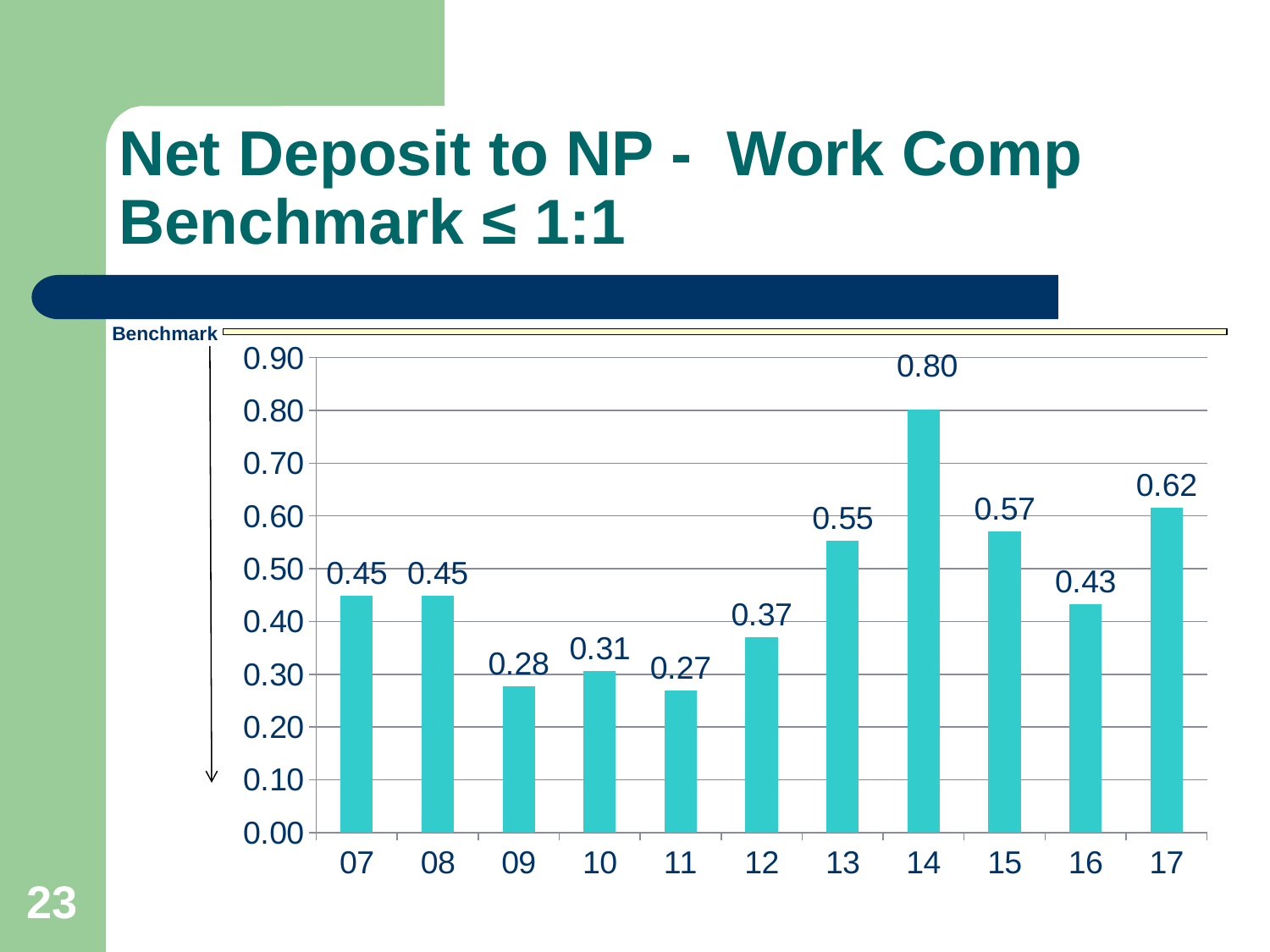
What is the value for 14? 0.80 How many years are shown on the x axis? 11 What is the title of the slide? Net Deposit to NP - Work Comp Benchmark ≤ 1:1 Do the values rise or fall from 11 to 14? rise What is the difference between the values for 14 and 13? 0.25 What is the value for 17? 0.62 What is the value for 09? 0.28 Which year has the highest value? 14 Is the value for 12 greater or less than 0.40? less What kind of chart is shown on the slide? bar chart Which is larger, the value for 15 or the value for 16? 15 Which year has the lowest value? 11